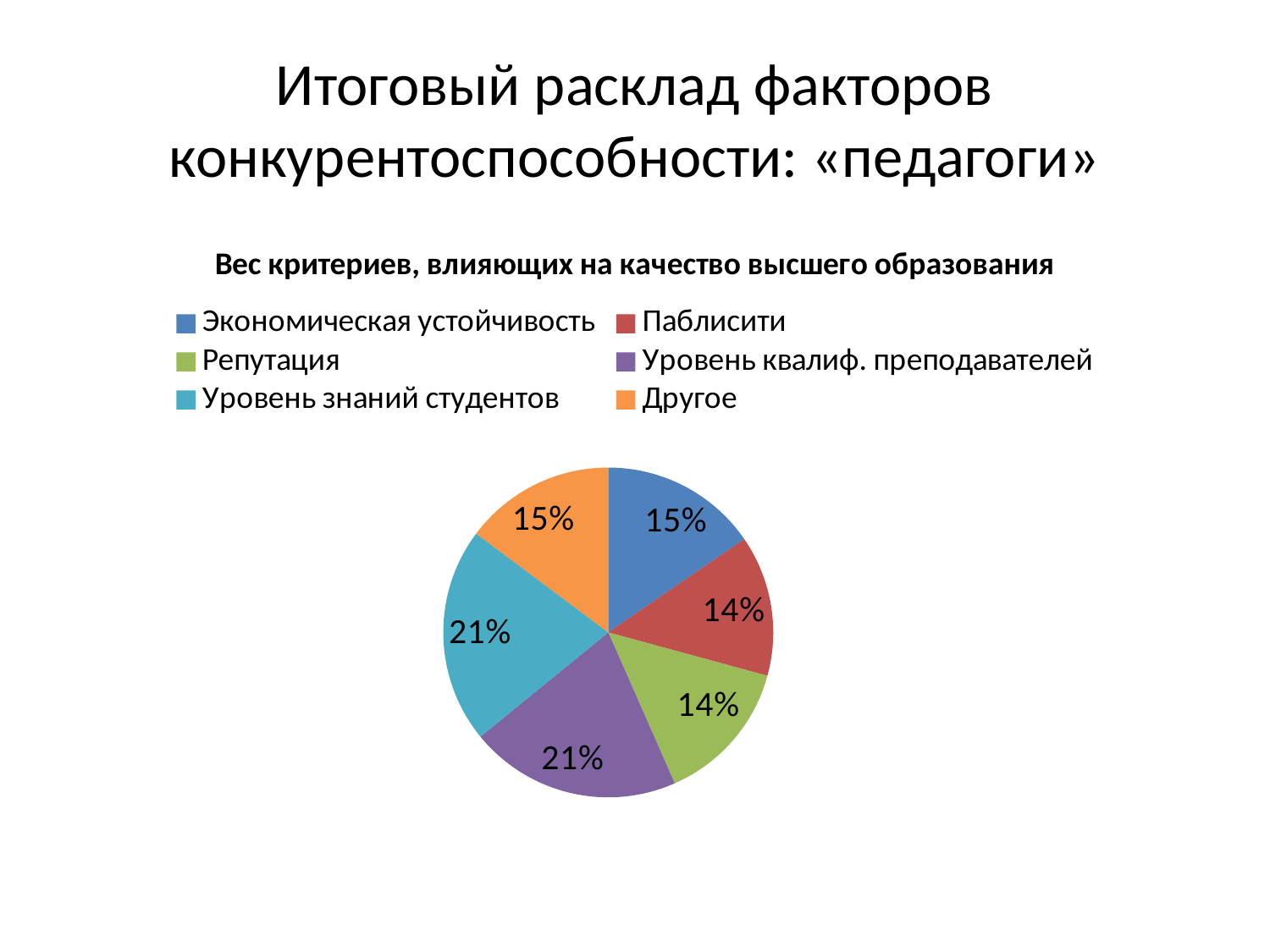
What is the title of the chart? Вес критериев, влияющих на качество высшего образования What is the difference in percentage points between Уровень квалиф. преподавателей and Репутация? 7 percentage points What share of the pie does Экономическая устойчивость have? 15% What share does Уровень квалиф. преподавателей have in the pie chart? 21% What is the value shown for Паблисити? 14% Which is larger: the share for Другое or the share for Репутация? Другое Which is larger: the share for Уровень знаний студентов or the share for Паблисити? Уровень знаний студентов How many slices does the pie chart have? 6 What is the value for Уровень знаний студентов? 21% What percentage is shown for Репутация? 14% What percentage is labelled for Другое? 15% What type of chart is shown on the slide? Pie chart